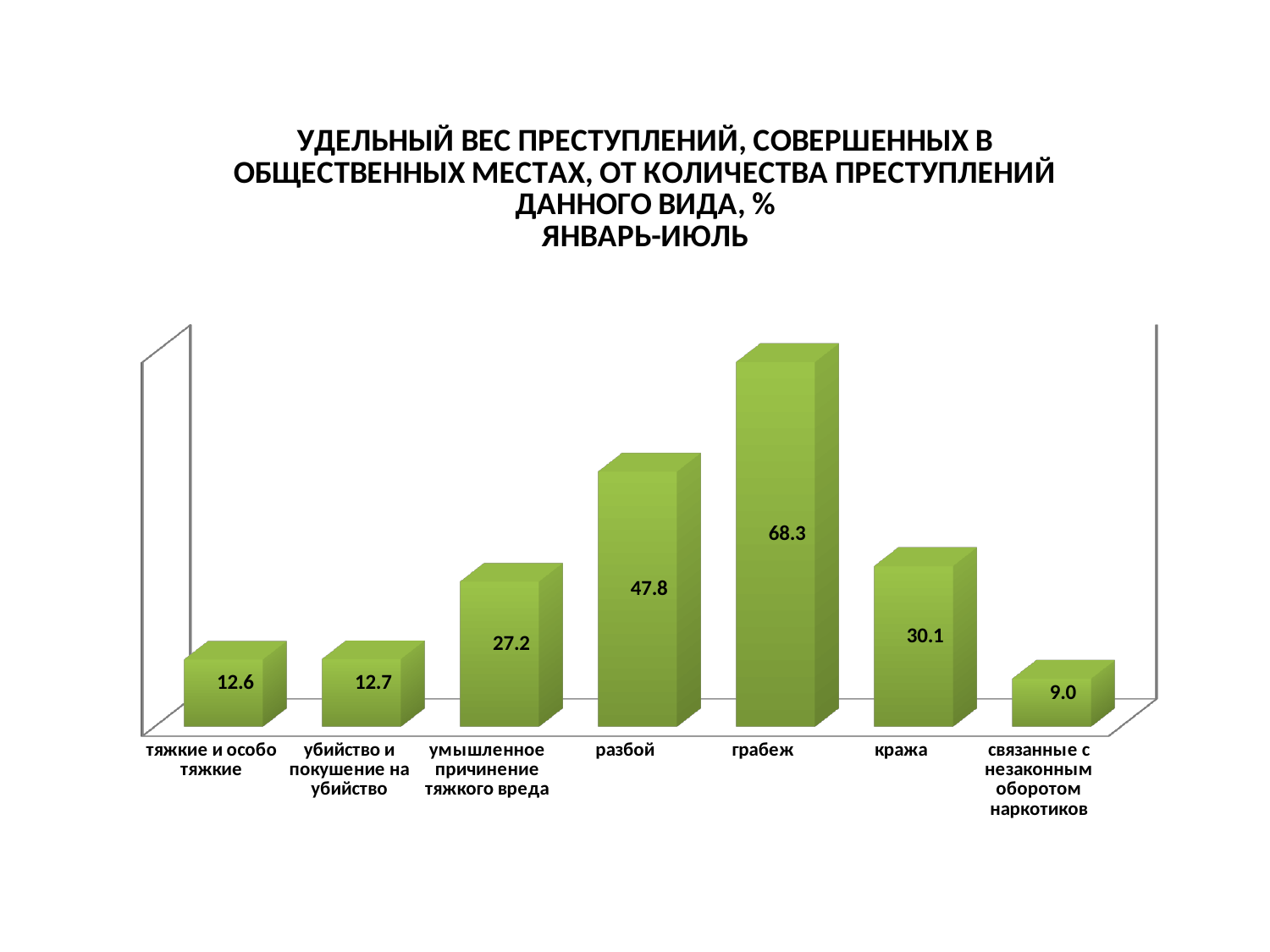
What is the value for кража? 30.1 Which is larger, the value for разбой or the value for кража? разбой What is the value for разбой? 47.8 How many categories are shown in the chart? 7 What is the difference between the values for грабеж and разбой? 20.5 What kind of chart is shown on the slide? bar chart What is the difference between the values for кража and связанные с незаконным оборотом наркотиков? 21.1 What colour are the bars in the chart? green What is the value for грабеж? 68.3 Which category has the lowest value? связанные с незаконным оборотом наркотиков What is the value for умышленное причинение тяжкого вреда? 27.2 Which category has the highest value? грабеж